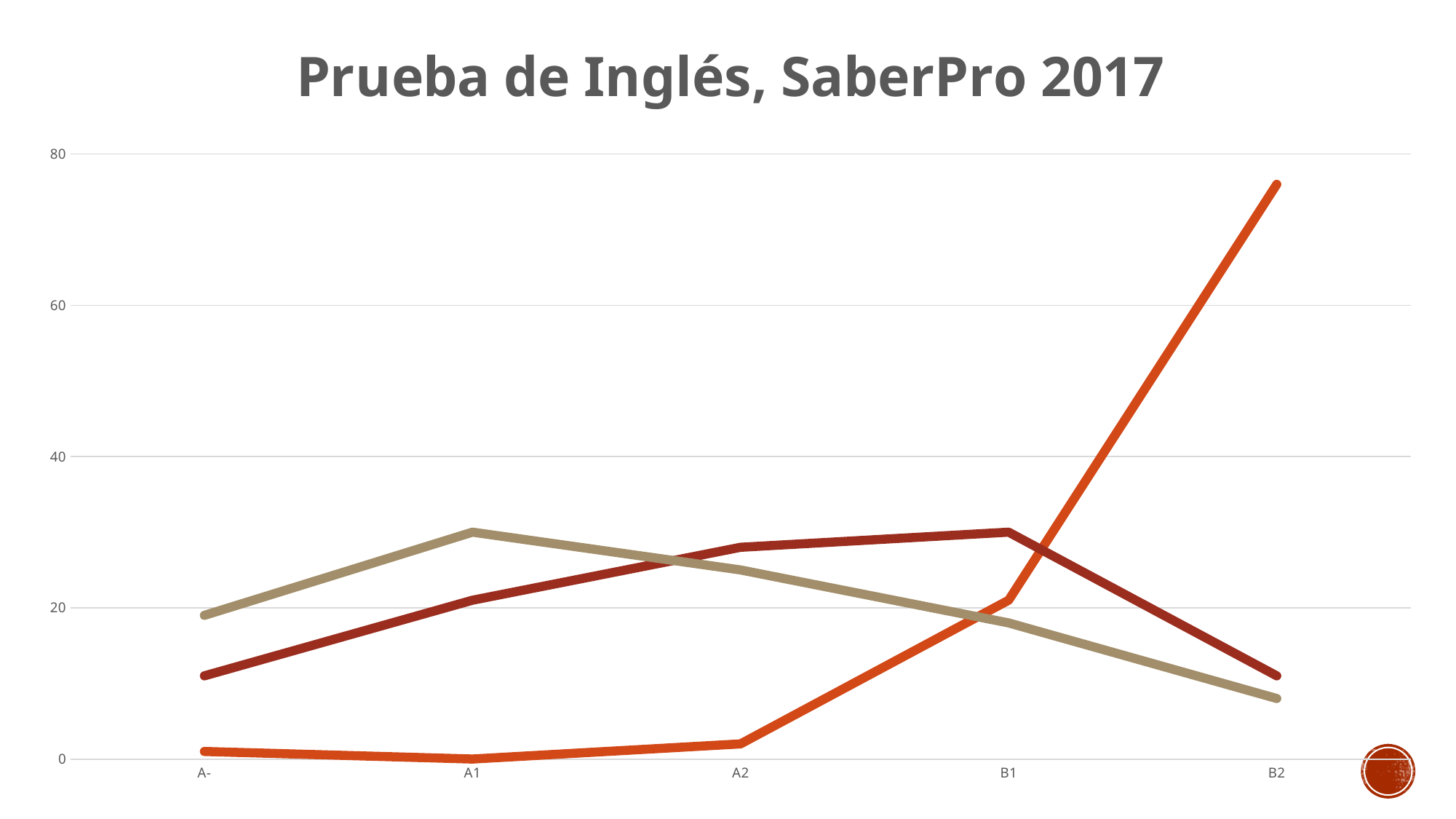
How many lines are plotted on the chart? 3 Is the value of the tan line at A1 greater or less than 20? greater Is the value of the dark red line at A- greater or less than 20? less At which category does the tan line reach its highest value? A1 At which category does the orange line reach its highest value? B2 Does the orange line generally rise or fall from A- to B2? rise At which category does the tan line reach its lowest value? B2 Is the value of the orange line at B2 greater or less than 60? greater What kind of chart is shown on the slide? line chart How many categories are shown on the x axis? 5 What is the title of the chart? Prueba de Inglés, SaberPro 2017 At B2, which line has the larger value, the orange line or the dark red line? the orange line